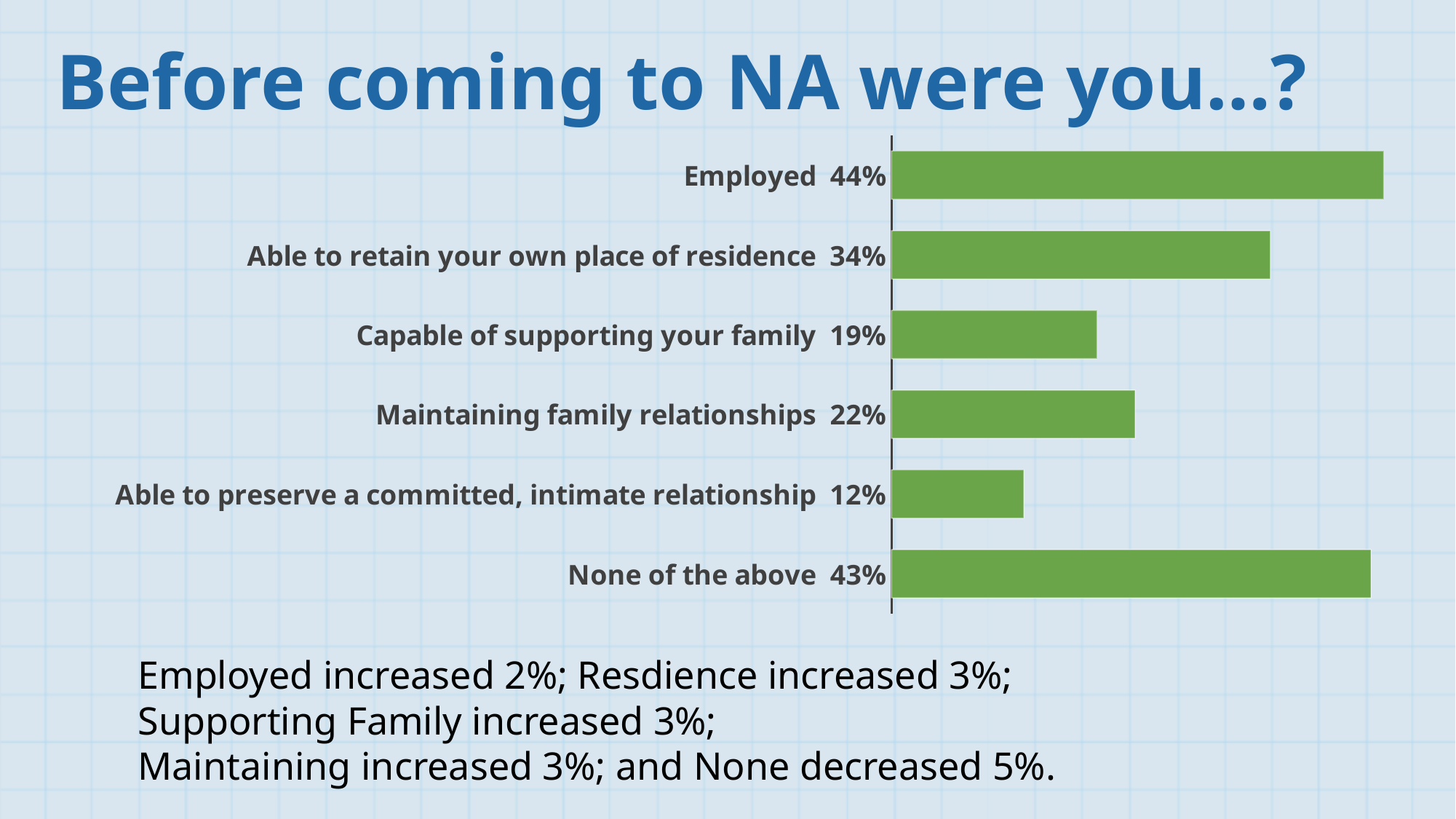
What percentage answered 'None of the above'? 43% How many categories are shown in the chart? 6 What is the value for 'Able to preserve a committed, intimate relationship'? 12% What is the title of the slide? Before coming to NA were you...? Which category has the highest value? Employed What kind of chart is shown on the slide? Bar chart What is the difference between 'Maintaining family relationships' and 'Capable of supporting your family'? 3% What percentage of respondents were employed before coming to NA? 44% Which is larger: 'Maintaining family relationships' or 'Capable of supporting your family'? Maintaining family relationships Which category has the lowest value? Able to preserve a committed, intimate relationship What is the value for 'Able to retain your own place of residence'? 34% What is the difference between 'Employed' and 'None of the above'? 1%